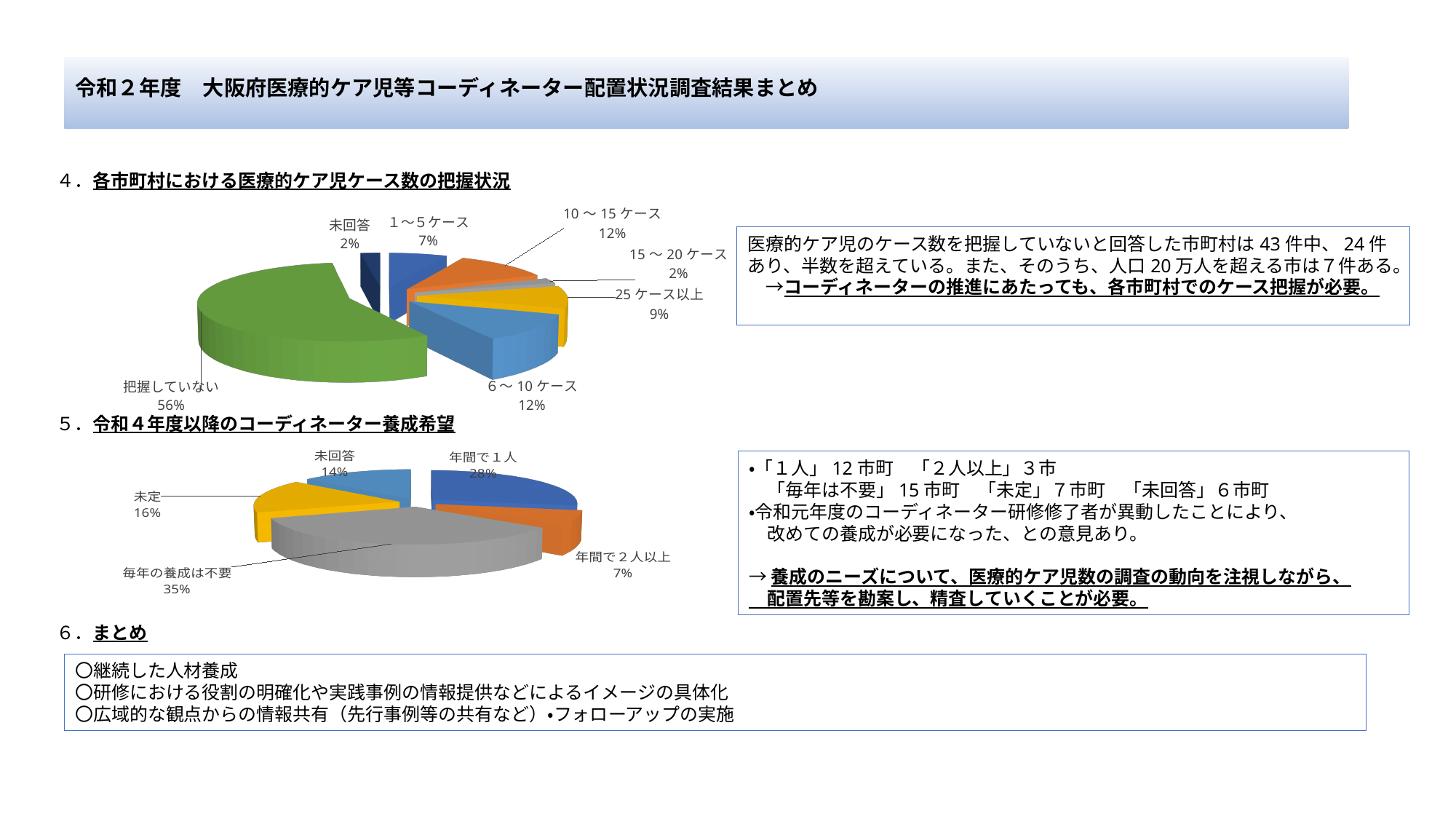
In the top pie chart (各市町村における医療的ケア児ケース数の把握状況), what is the difference in percentage points between 把握していない and 6～10ケース? 44 In the bottom pie chart (令和４年度以降のコーディネーター養成希望), how many slices does the pie have? 5 In the bottom pie chart (令和４年度以降のコーディネーター養成希望), what is the difference in percentage points between 未定 and 未回答? 2 In the bottom pie chart (令和４年度以降のコーディネーター養成希望), what share is labelled 毎年の養成は不要? 35% What type of chart is used in section 5 (令和４年度以降のコーディネーター養成希望)? Pie chart In the top pie chart (各市町村における医療的ケア児ケース数の把握状況), which is larger: 1～5ケース or 6～10ケース? 6～10ケース In the bottom pie chart (令和４年度以降のコーディネーター養成希望), which category has the smallest share? 年間で２人以上 In the bottom pie chart (令和４年度以降のコーディネーター養成希望), what share is labelled 年間で１人? 28% In the top pie chart (各市町村における医療的ケア児ケース数の把握状況), which category has the largest share? 把握していない In the top pie chart (各市町村における医療的ケア児ケース数の把握状況), how many slices does the pie have? 7 In the top pie chart (各市町村における医療的ケア児ケース数の把握状況), what share is labelled 25ケース以上? 9% In the top pie chart (各市町村における医療的ケア児ケース数の把握状況), what share is labelled 把握していない? 56%